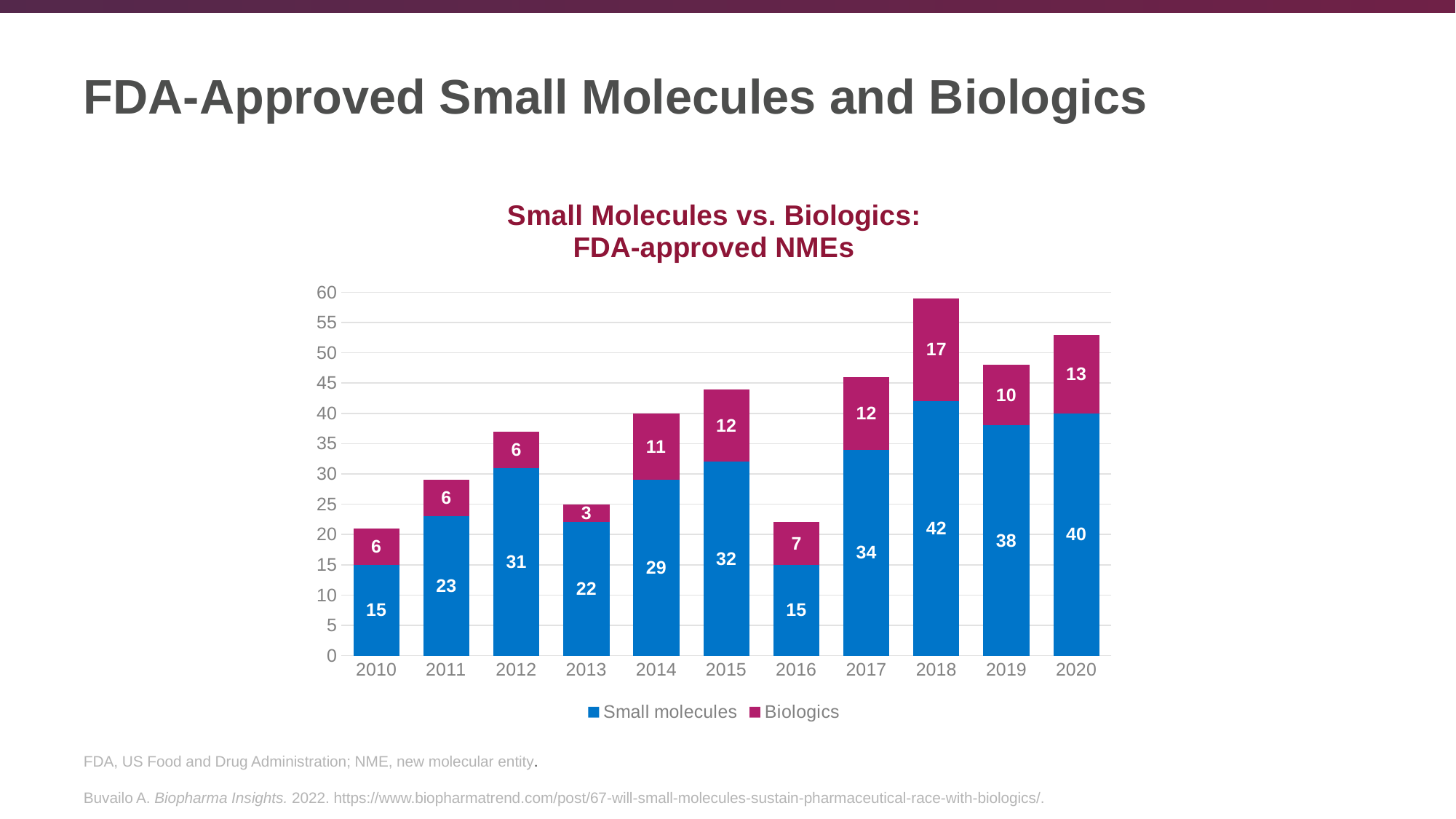
What kind of chart is shown on the slide? Stacked bar chart What is the value for Biologics in 2013? 3 Which colour represents Biologics in the chart? Magenta How many series does the legend list? 2 What is the difference between the Small molecules values for 2020 and 2010? 25 How many years are shown on the x axis? 11 Which is larger, the Small molecules value for 2012 or for 2014? 2012 Which year has the lowest value for Biologics? 2013 What is the total of the stacked bar for 2016? 22 Which year has the highest value for Biologics? 2018 What is the total of the stacked bar for 2018? 59 What is the value for Small molecules in 2018? 42